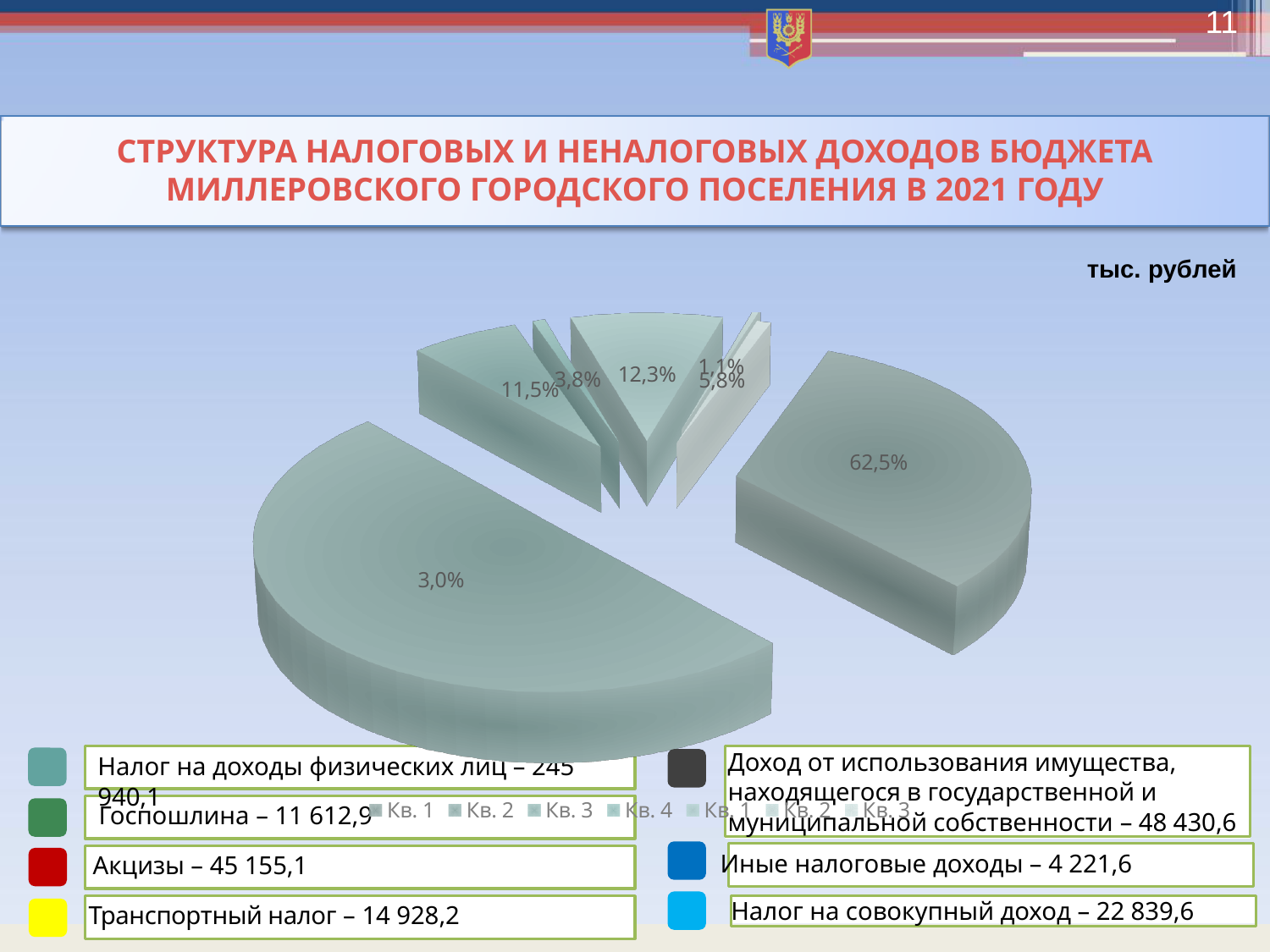
According to the labelled boxes below the chart, what is the value for Транспортный налог? 14 928,2 According to the labelled boxes below the chart, what is the value for Акцизы? 45 155,1 Which is larger: the slice labelled 12,3% or the slice labelled 11,5%? 12,3% Which is larger: the slice labelled 5,8% or the slice labelled 3,8%? 5,8% Is the largest slice of the pie chart greater or less than 50%? greater How many entries does the chart legend list? 7 How many slices does the pie chart have? 7 What unit of measurement is stated above the chart? тыс. рублей What is the difference in percentage points between the largest slice (62,5%) and the slice labelled 12,3%? 50,2 What kind of chart is shown on the slide? pie chart